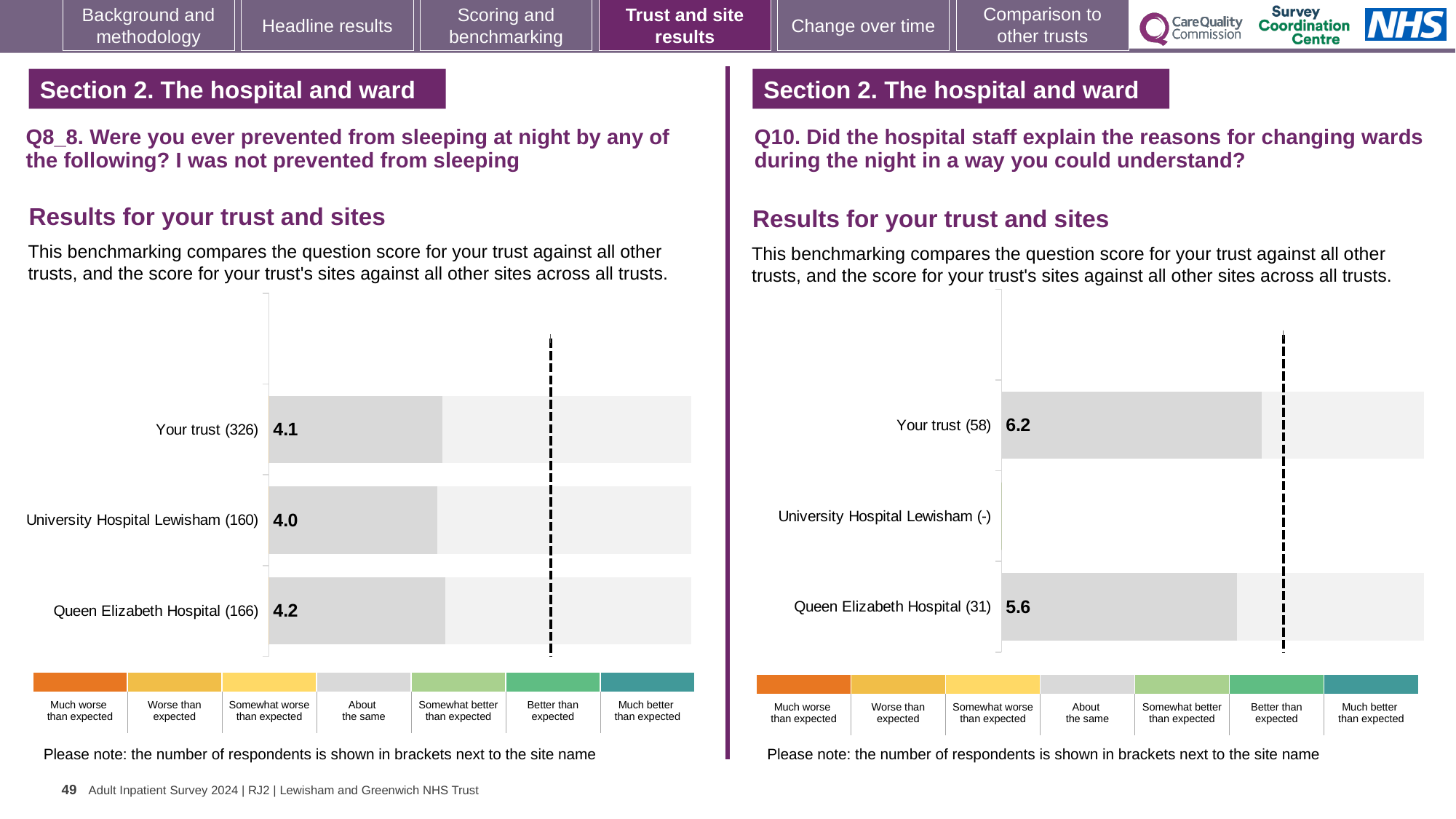
How many bars are plotted in the Q8_8 chart on the left? 3 In the Q10 chart on the right, what is the score for Queen Elizabeth Hospital? 5.6 In the Q10 chart on the right, how many respondents are shown in brackets for Queen Elizabeth Hospital? 31 In the Q8_8 chart on the left, which site or trust has the highest score? Queen Elizabeth Hospital In the Q8_8 chart on the left, what is the difference between the scores for Queen Elizabeth Hospital and University Hospital Lewisham? 0.2 In the Q8_8 chart on the left, what is the score for University Hospital Lewisham? 4.0 In the Q10 chart on the right, which has the larger score, Your trust or Queen Elizabeth Hospital? Your trust What type of chart is used in the Q8_8 chart on the left? Bar chart In the Q8_8 chart on the left, what is the score for Queen Elizabeth Hospital? 4.2 In the Q10 chart on the right, what is the difference between the scores for Your trust and Queen Elizabeth Hospital? 0.6 In the Q8_8 chart on the left, what is the score for Your trust? 4.1 In the Q10 chart on the right, what is the score for Your trust? 6.2